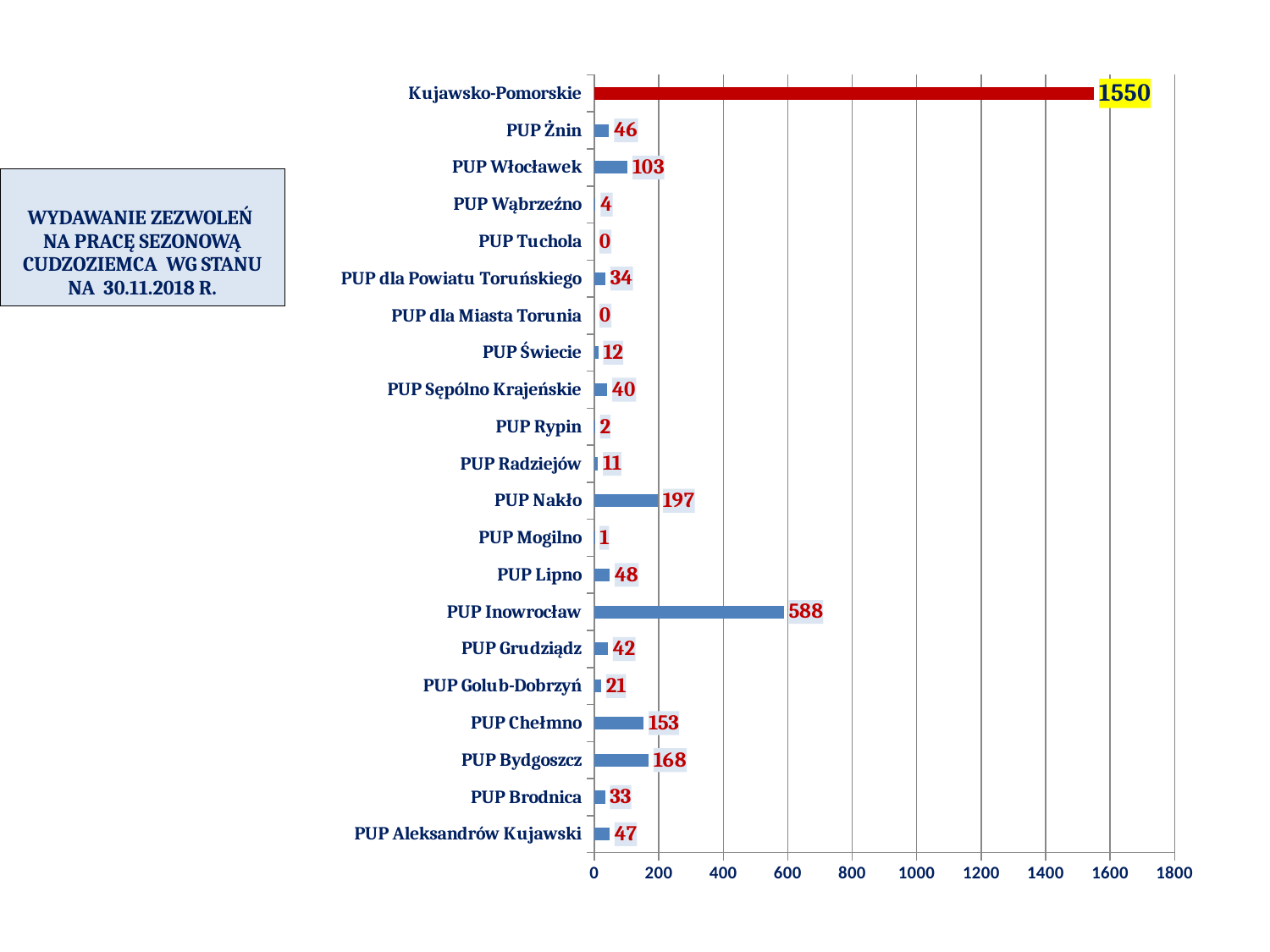
Is the value for PUP Inowrocław greater or less than 400? greater Which category has the highest value in the chart? Kujawsko-Pomorskie What value is shown for PUP Nakło? 197 What value is shown for PUP Bydgoszcz? 168 Which is larger, the value for PUP Włocławek or the value for PUP Żnin? PUP Włocławek How many categories (bars) are shown in the chart? 21 Which PUP has the highest value among the PUP categories? PUP Inowrocław What value is shown for PUP Inowrocław? 588 What value is shown for Kujawsko-Pomorskie? 1550 What kind of chart is shown on the slide? Bar chart What is the difference between the values for PUP Inowrocław and PUP Nakło? 391 What is the difference between the values for PUP Bydgoszcz and PUP Chełmno? 15